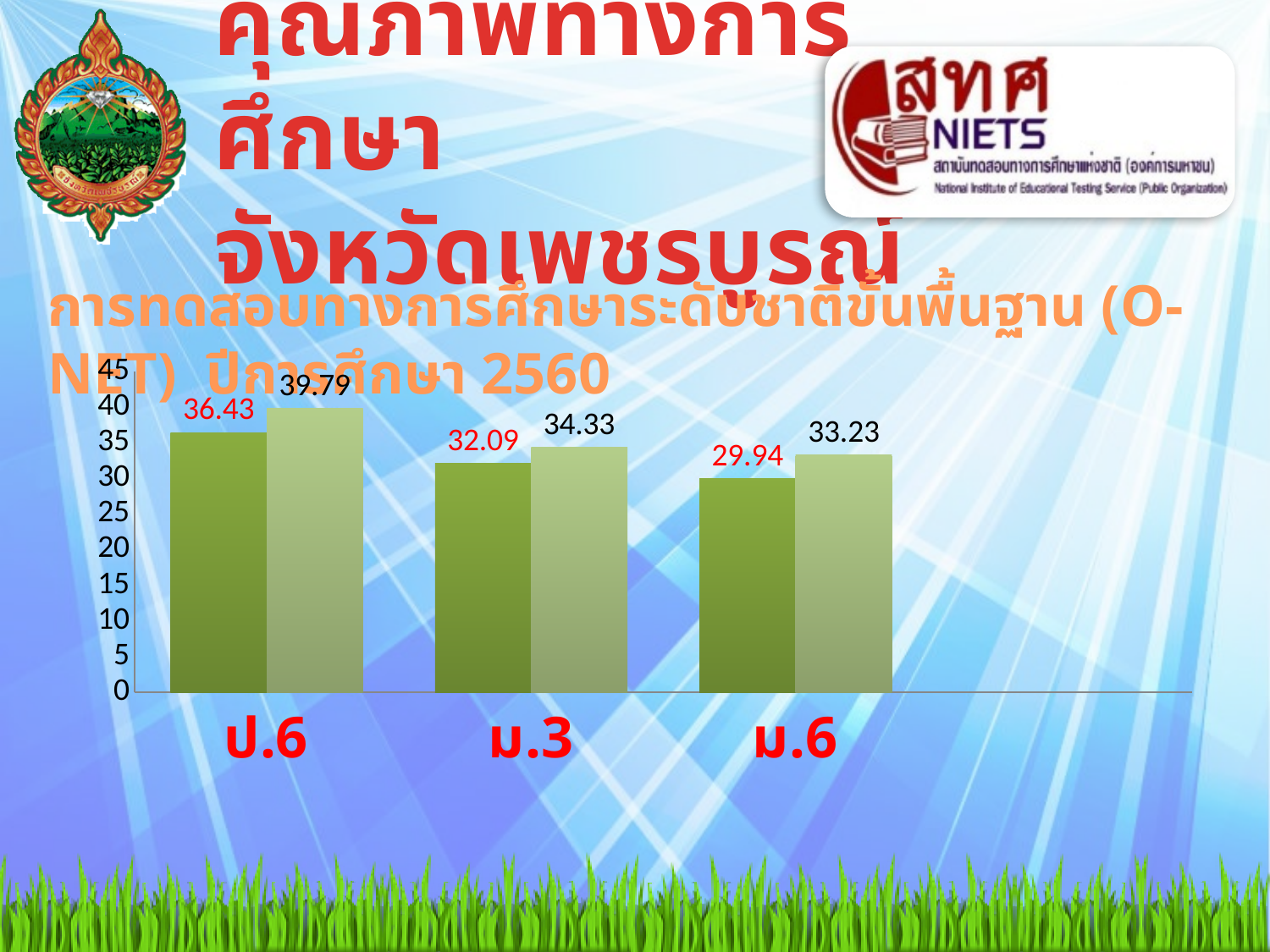
Which category has the highest value for the dark green (first) bars? ป.6 What is the value of the light green (second) bar for ป.6? 39.79 What is the value of the dark green (first) bar for ป.6? 36.43 What is the value of the dark green (first) bar for ม.3? 32.09 Do the values of the dark green bars rise or fall from ป.6 to ม.6? fall What is the value of the light green (second) bar for ม.6? 33.23 How many categories are shown on the x axis of the chart? 3 Which is larger for ม.6: the dark green bar or the light green bar? the light green bar What type of chart is shown on the slide? bar chart What is the difference between the light green bar and the dark green bar for ม.3? 2.24 What is the highest value shown on the vertical axis of the chart? 45 Which category has the lowest value for the light green (second) bars? ม.6